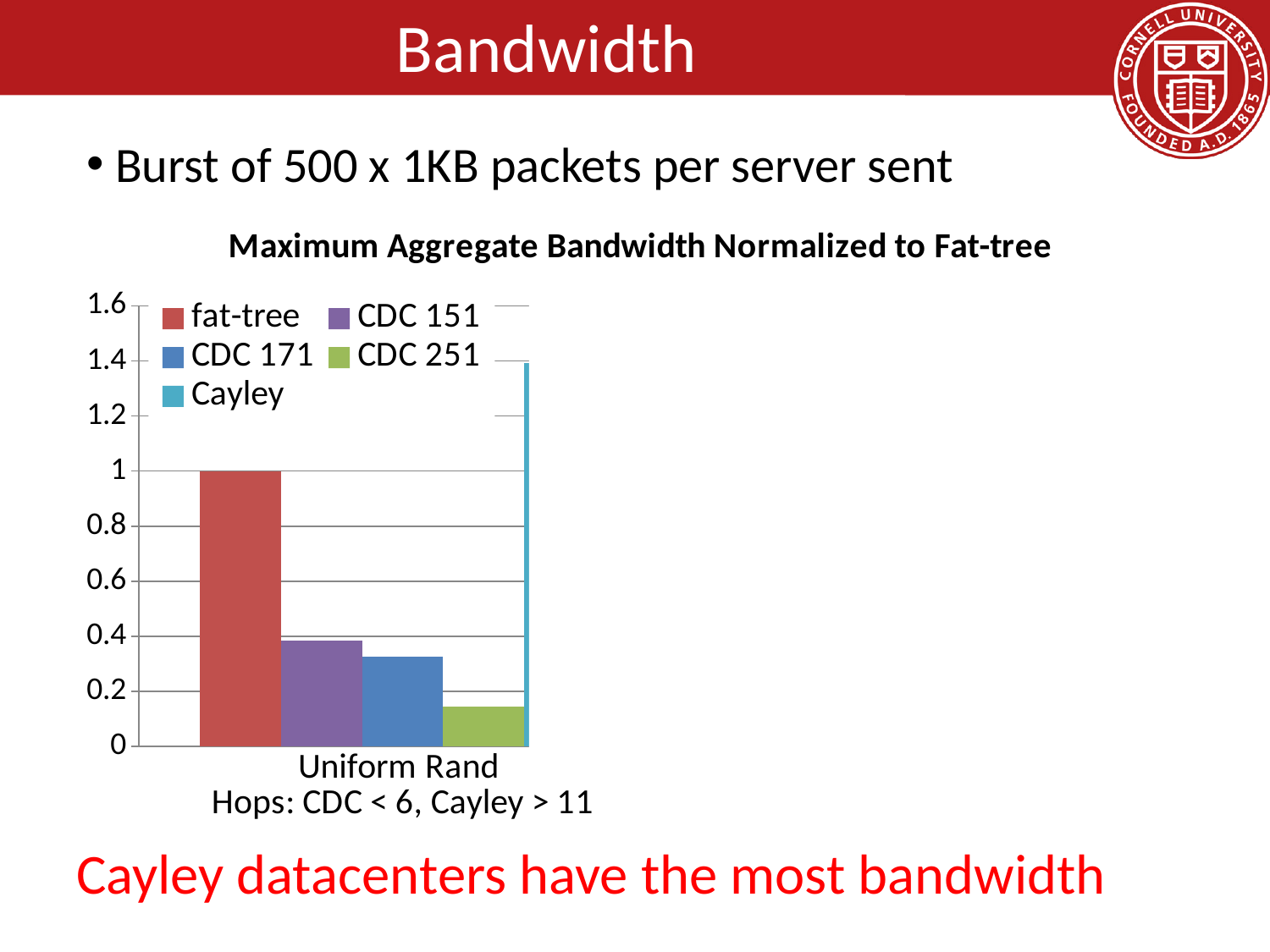
How many categories are shown on the x axis? 1 Is the value for Cayley greater or less than 1.2? greater Which series has the highest bar? Cayley Is the value for CDC 251 greater or less than 0.2? less How many series does the legend list? 5 What is the value for fat-tree? 1 What kind of chart is shown on the slide? bar chart What is the title of the chart? Maximum Aggregate Bandwidth Normalized to Fat-tree Which series has the lowest bar? CDC 251 Is the value for CDC 171 greater or less than 0.2? greater Which is larger, the value for CDC 151 or the value for CDC 171? CDC 151